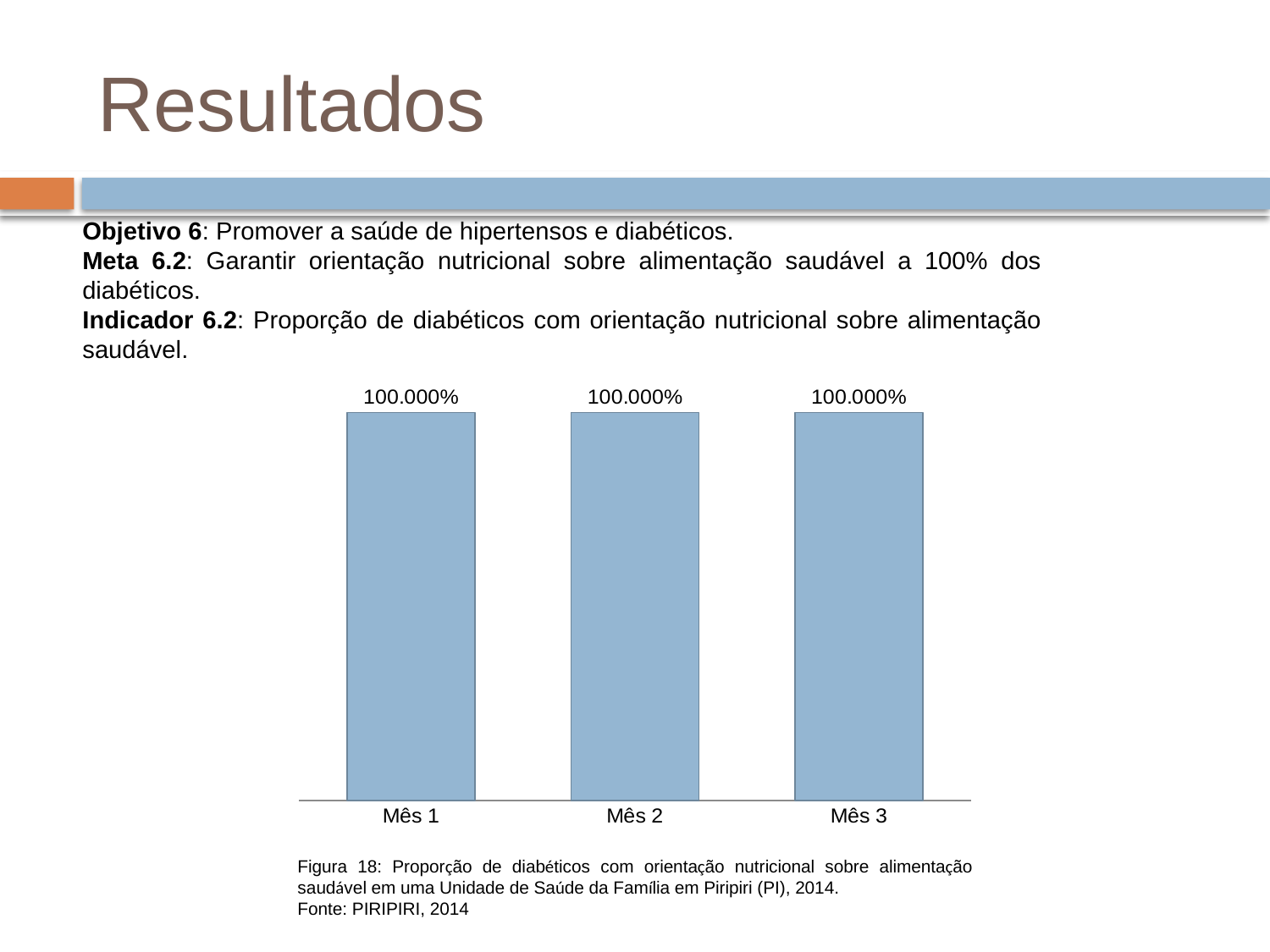
What is the label of the first category on the x axis? Mês 1 How many categories (months) are plotted in the chart? 3 Is the value for Mês 2 larger than, smaller than, or equal to the value for Mês 1? equal Do the values rise, fall, or stay the same from Mês 1 to Mês 3? stay the same What is the value for Mês 3? 100.000% What is the value for Mês 2? 100.000% What kind of chart is shown on the slide? bar chart What figure number is given in the caption below the chart? Figura 18 What is the difference between the values for Mês 1 and Mês 3? 0.000% What is the value for Mês 1? 100.000%